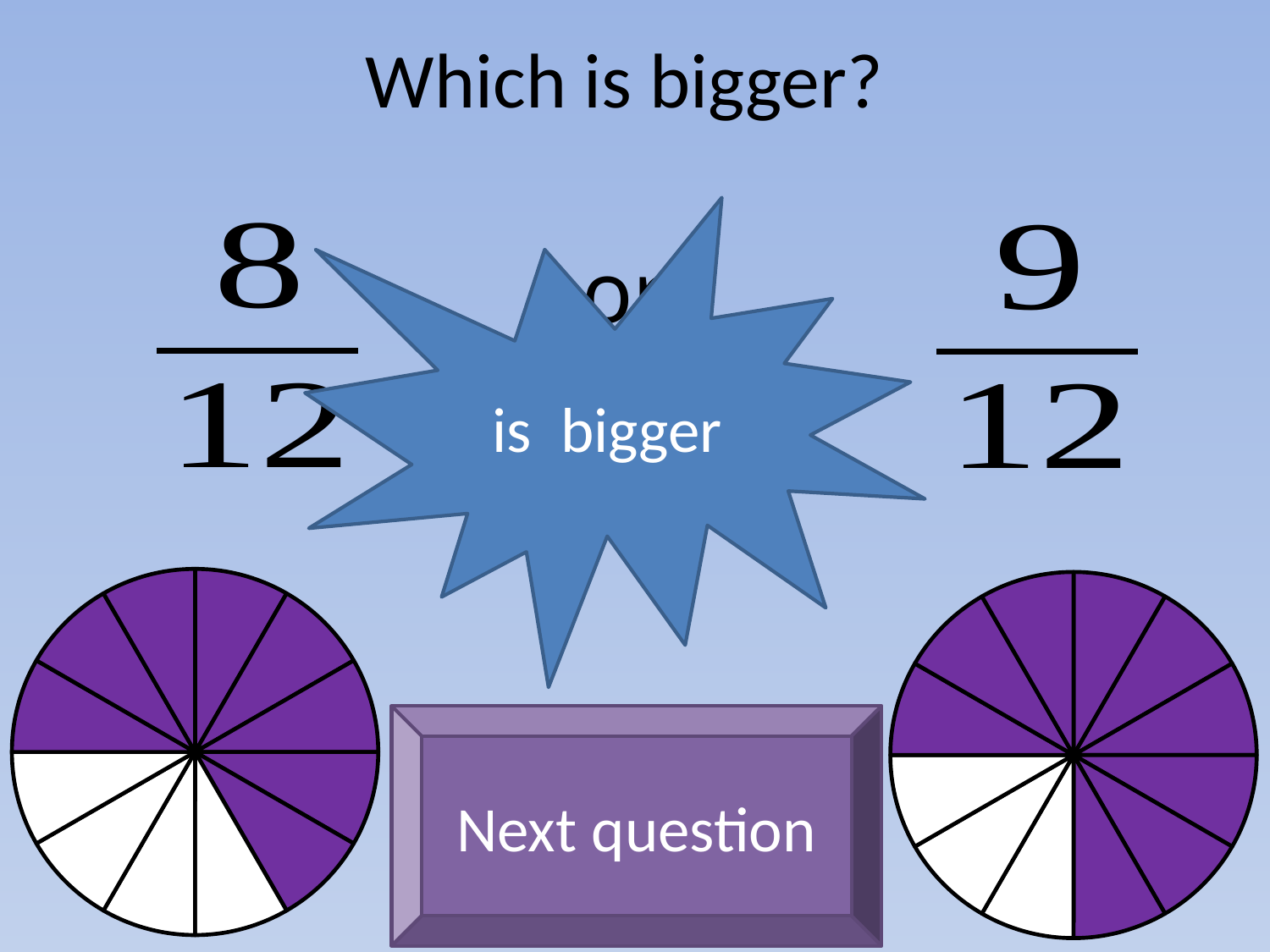
What is the title at the top of the slide? Which is bigger? What fraction is shown above the right circle? 9/12 Which circle has more purple shaded sectors, the left or the right? right What fraction is shown above the left circle? 8/12 What kind of diagram is used to show each fraction on the slide? pie chart How many equal sectors is the right circle divided into? 12 How many sectors of the right circle are left white? 3 How many sectors of the left circle are left white? 4 How many sectors of the right circle are shaded purple? 9 How many equal sectors is the left circle divided into? 12 How many more sectors are shaded in the right circle than in the left circle? 1 How many sectors of the left circle are shaded purple? 8